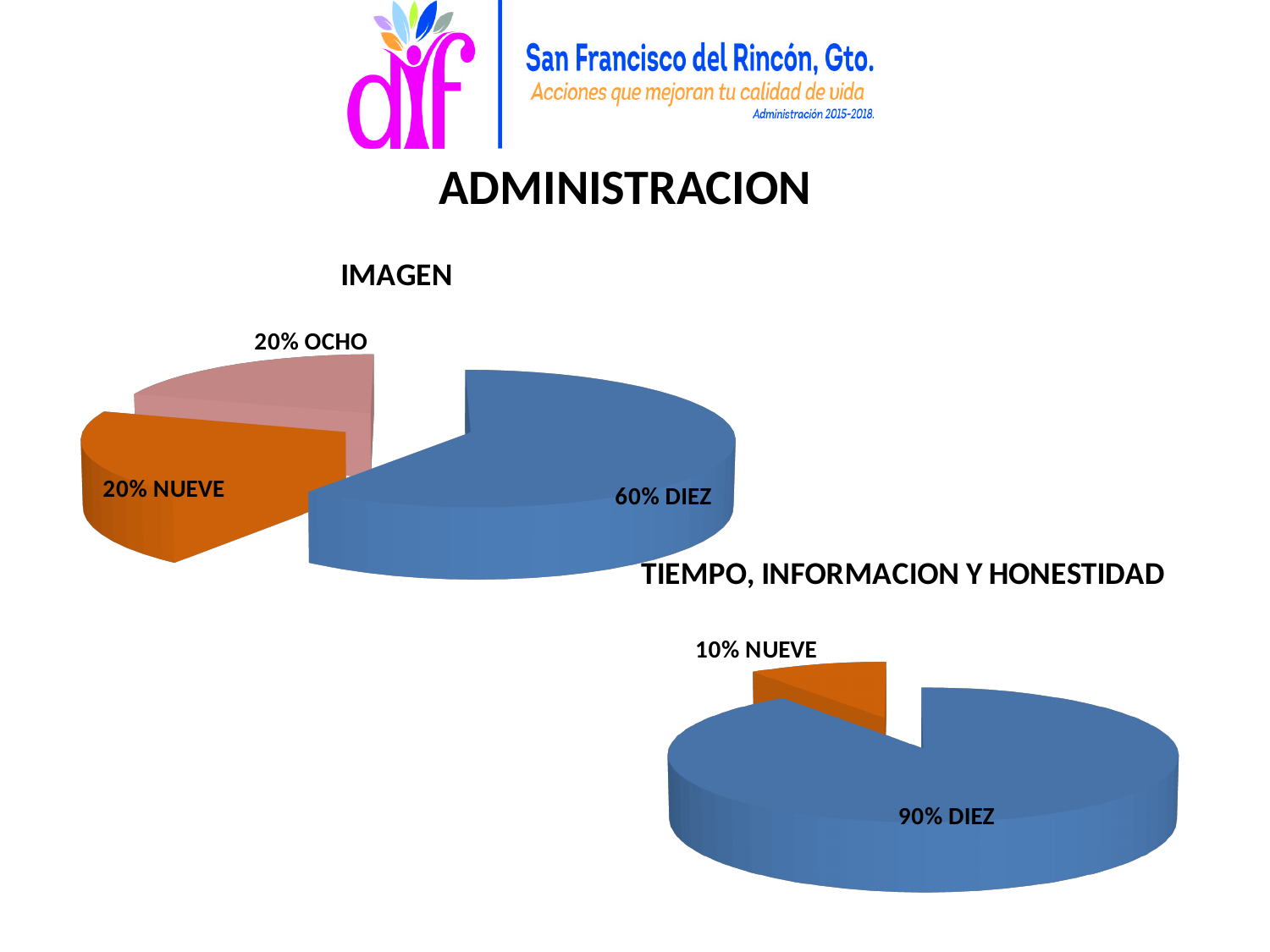
In the TIEMPO, INFORMACION Y HONESTIDAD chart, what share does the NUEVE slice have? 10% In the IMAGEN chart, what is the difference in percentage points between the DIEZ slice and the NUEVE slice? 40 In the TIEMPO, INFORMACION Y HONESTIDAD chart, which category has the smallest slice? NUEVE In the TIEMPO, INFORMACION Y HONESTIDAD chart, how many slices does the pie have? 2 In the IMAGEN chart, which category has the largest slice? DIEZ In the IMAGEN chart, which is larger, the DIEZ slice or the OCHO slice? DIEZ In the IMAGEN chart, what share does the OCHO slice have? 20% In the TIEMPO, INFORMACION Y HONESTIDAD chart, what share does the DIEZ slice have? 90% What is the title of the chart at the bottom right of the slide? TIEMPO, INFORMACION Y HONESTIDAD What type of chart is the IMAGEN chart? Pie chart In the IMAGEN chart, how many slices does the pie have? 3